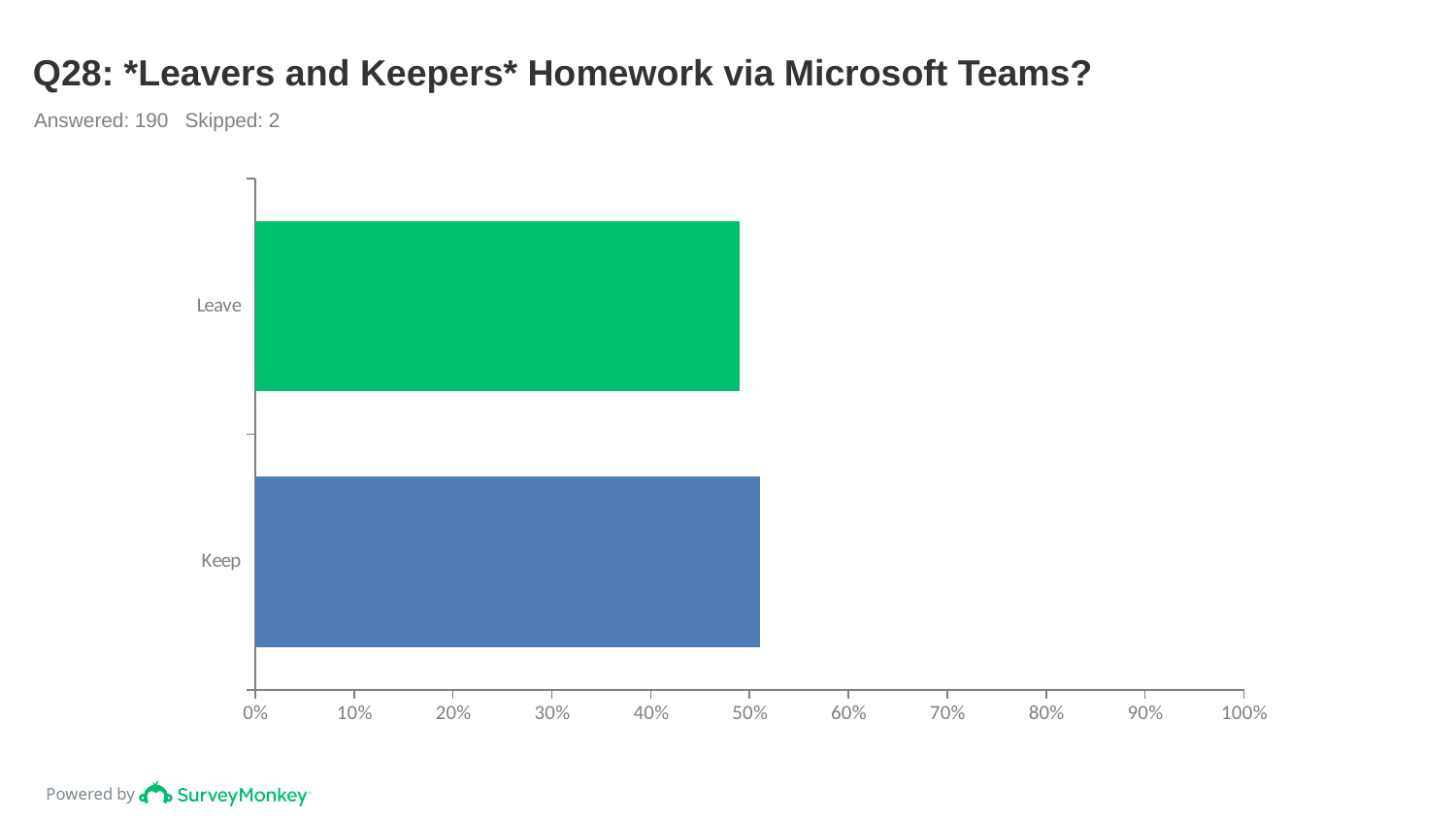
How many categories are plotted in the chart? 2 Is the value for Keep greater or less than 60%? less Is the value for Leave greater or less than 40%? greater Which bar is longer, Leave or Keep? Keep What is the title of the chart? Q28: *Leavers and Keepers* Homework via Microsoft Teams? What is the highest value shown on the x axis? 100% What kind of chart is shown on the slide? bar chart How many respondents answered this question according to the slide? 190